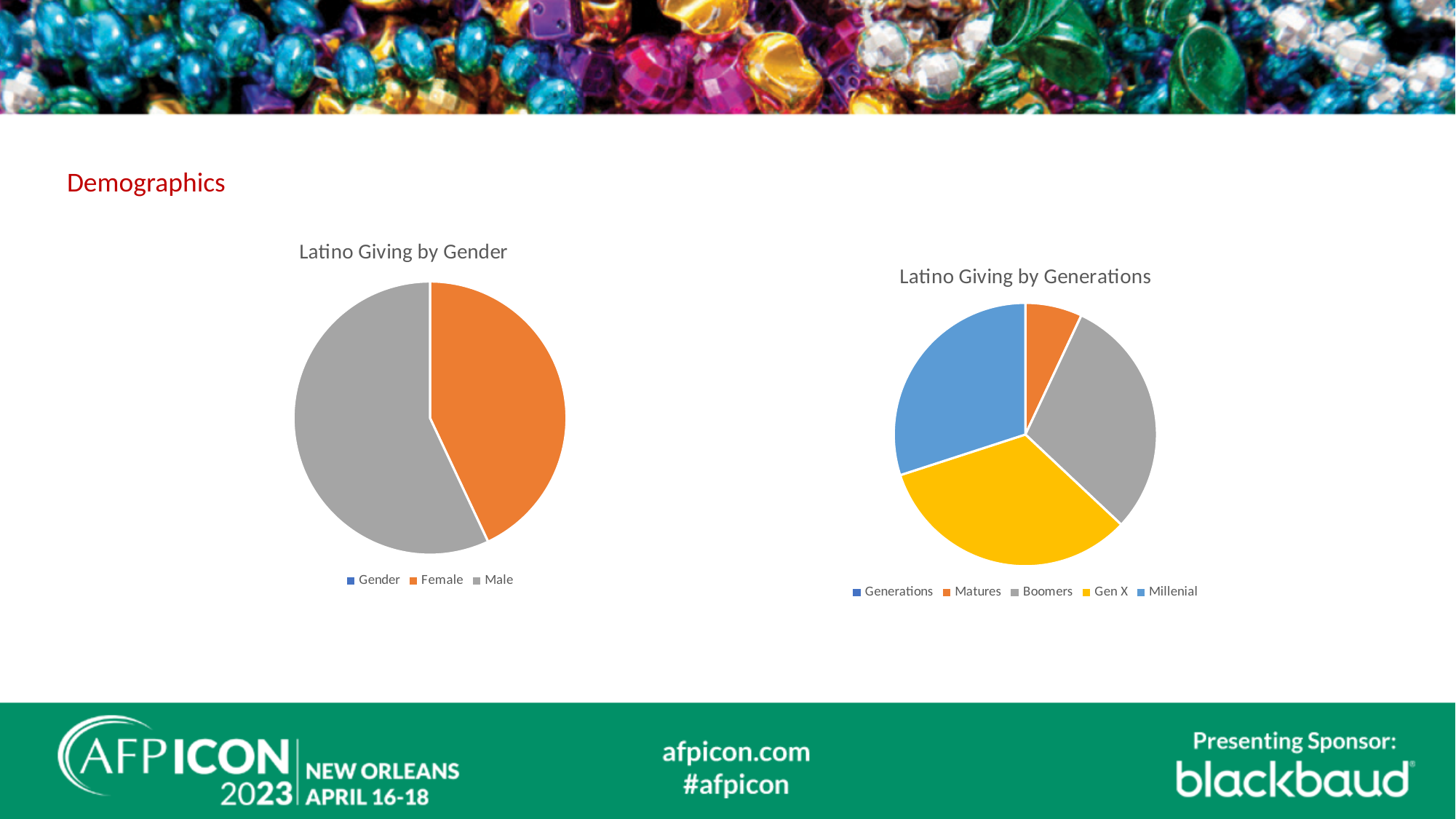
How many entries does the legend of the "Latino Giving by Generations" chart list? 5 In the "Latino Giving by Generations" chart, which slice is the smallest? Matures In the "Latino Giving by Gender" chart, which slice is the largest? Male What kind of chart is "Latino Giving by Generations"? pie chart How many slices does the "Latino Giving by Generations" pie have? 4 What kind of chart is "Latino Giving by Gender"? pie chart In the "Latino Giving by Generations" chart, which is larger, Millenial or Matures? Millenial In the "Latino Giving by Generations" chart, which is larger, Matures or Gen X? Gen X How many slices does the "Latino Giving by Gender" pie have? 2 In the "Latino Giving by Generations" chart, what colour is the Gen X slice? yellow In the "Latino Giving by Gender" chart, which is larger, Female or Male? Male In the "Latino Giving by Generations" chart, which slice is the largest? Gen X